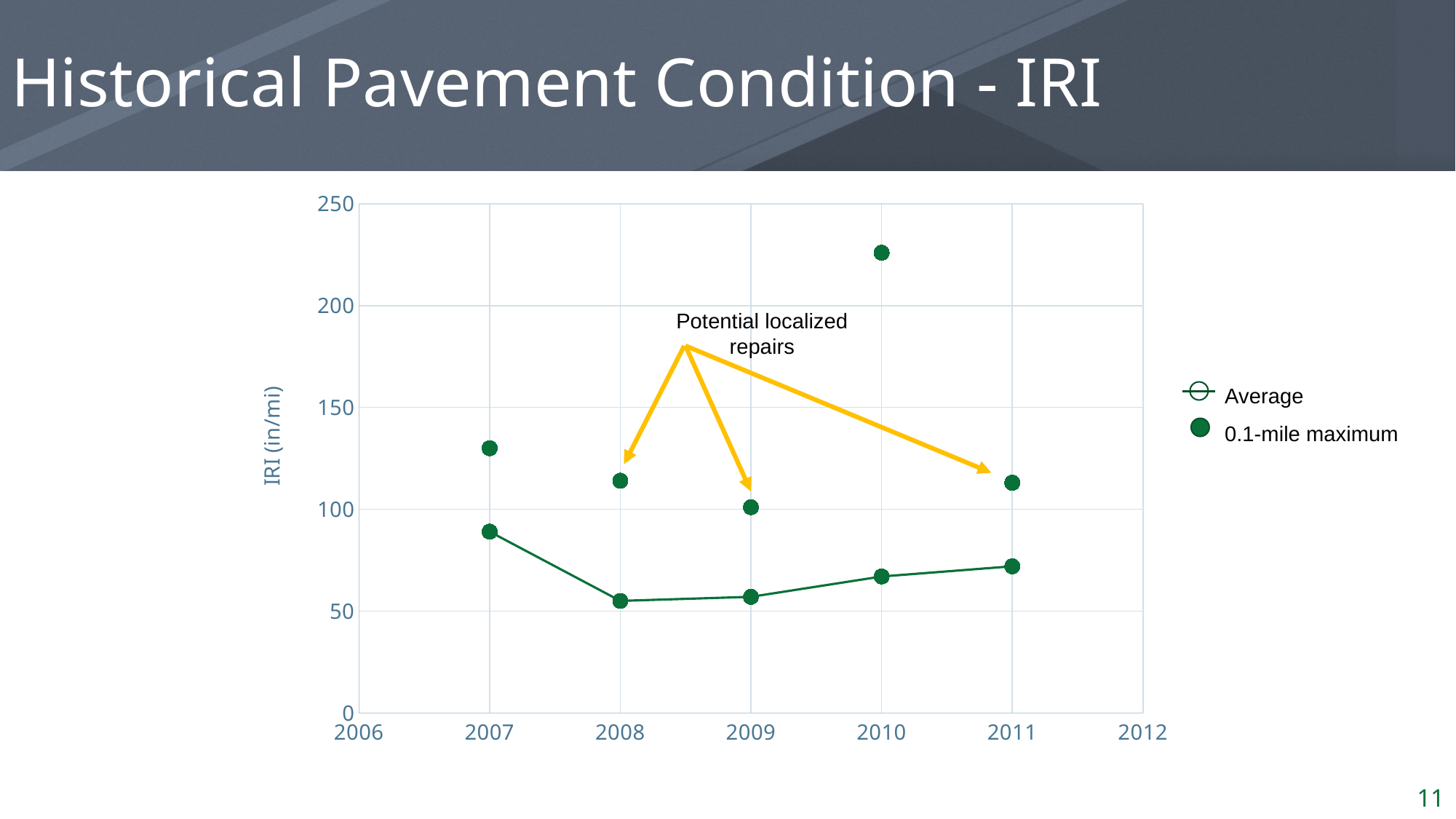
Is the 0.1-mile maximum for 2007 greater or less than 100? greater In which year is the 0.1-mile maximum lowest? 2009 In which year is the 0.1-mile maximum highest? 2010 Which is larger, the Average for 2007 or the Average for 2011? 2007 In which year is the Average highest? 2007 What kind of chart is shown on the slide? line chart Is the 0.1-mile maximum for 2010 greater or less than 200? greater Does the Average rise or fall from 2008 to 2011? rise For how many years are data points plotted? 5 What is the label on the y axis? IRI (in/mi) How many series does the legend list? 2 Is the Average for 2007 greater or less than 100? less